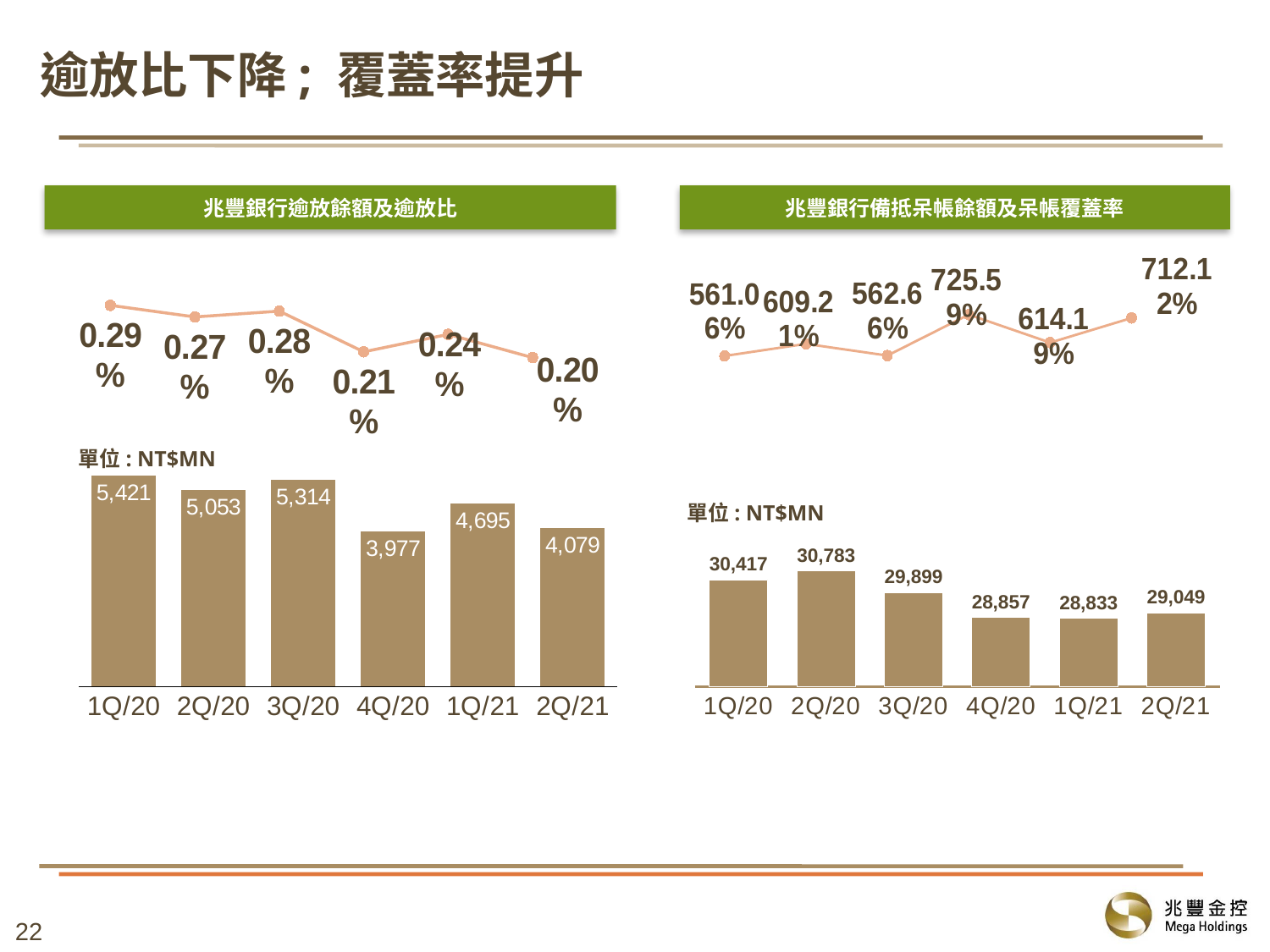
In the right chart (兆豐銀行備抵呆帳餘額及呆帳覆蓋率), what is the bar value for 2Q/20? 30,783 In the left chart (兆豐銀行逾放餘額及逾放比), which quarter has the highest bar value? 1Q/20 In the right chart (兆豐銀行備抵呆帳餘額及呆帳覆蓋率), which quarter has the lowest bar value? 1Q/21 In the left chart (兆豐銀行逾放餘額及逾放比), what is the line value (逾放比) for 1Q/20? 0.29% In the left chart (兆豐銀行逾放餘額及逾放比), how many quarters are shown on the x axis? 6 What unit is stated for the bar values in both charts? NT$MN In the right chart (兆豐銀行備抵呆帳餘額及呆帳覆蓋率), what is the 呆帳覆蓋率 line value for 4Q/20? 725.59% In the right chart (兆豐銀行備抵呆帳餘額及呆帳覆蓋率), what is the difference between the bar values for 2Q/21 and 1Q/21? 216 In the right chart (兆豐銀行備抵呆帳餘額及呆帳覆蓋率), which is larger, the bar value for 1Q/20 or 2Q/20? 2Q/20 In the left chart (兆豐銀行逾放餘額及逾放比), what is the bar value for 4Q/20? 3,977 In the left chart (兆豐銀行逾放餘額及逾放比), which quarter has the lowest 逾放比 on the line? 2Q/21 In the left chart (兆豐銀行逾放餘額及逾放比), what is the difference between the bar values for 1Q/20 and 2Q/21? 1,342